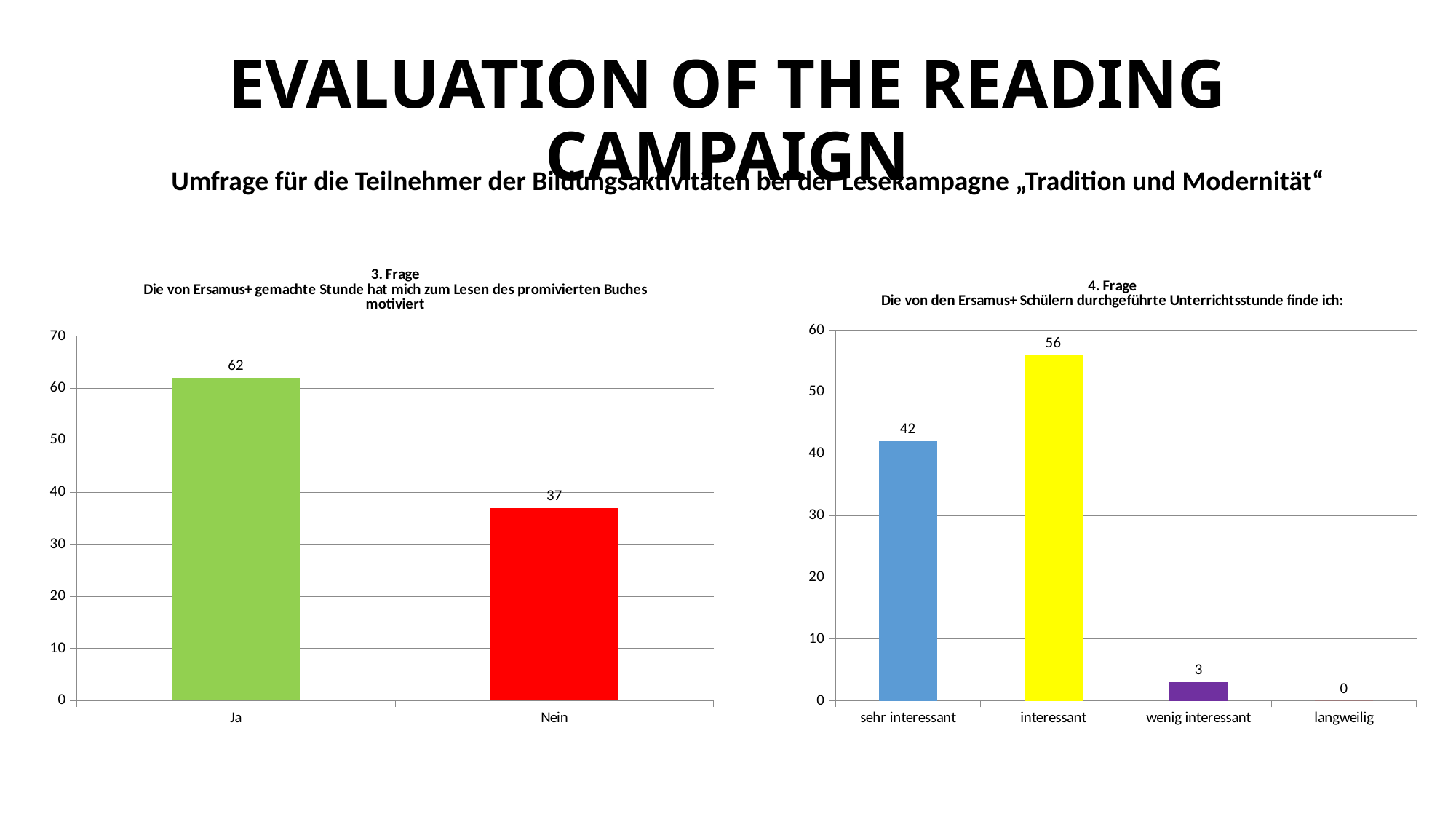
What kind of chart is the right chart (4. Frage)? Bar chart In the left chart (3. Frage), what is the value for Nein? 37 In the right chart (4. Frage), which category has the highest value? interessant In the left chart (3. Frage), what is the value for Ja? 62 In the right chart (4. Frage), what is the difference between the values for interessant and sehr interessant? 14 In the right chart (4. Frage), which category has the lowest value? langweilig In the right chart (4. Frage), what is the value for interessant? 56 In the left chart (3. Frage), how many categories are shown? 2 In the right chart (4. Frage), what is the value for wenig interessant? 3 In the left chart (3. Frage), what is the difference between the values for Ja and Nein? 25 In the left chart (3. Frage), which category has the higher value, Ja or Nein? Ja In the right chart (4. Frage), how many categories are shown on the x axis? 4